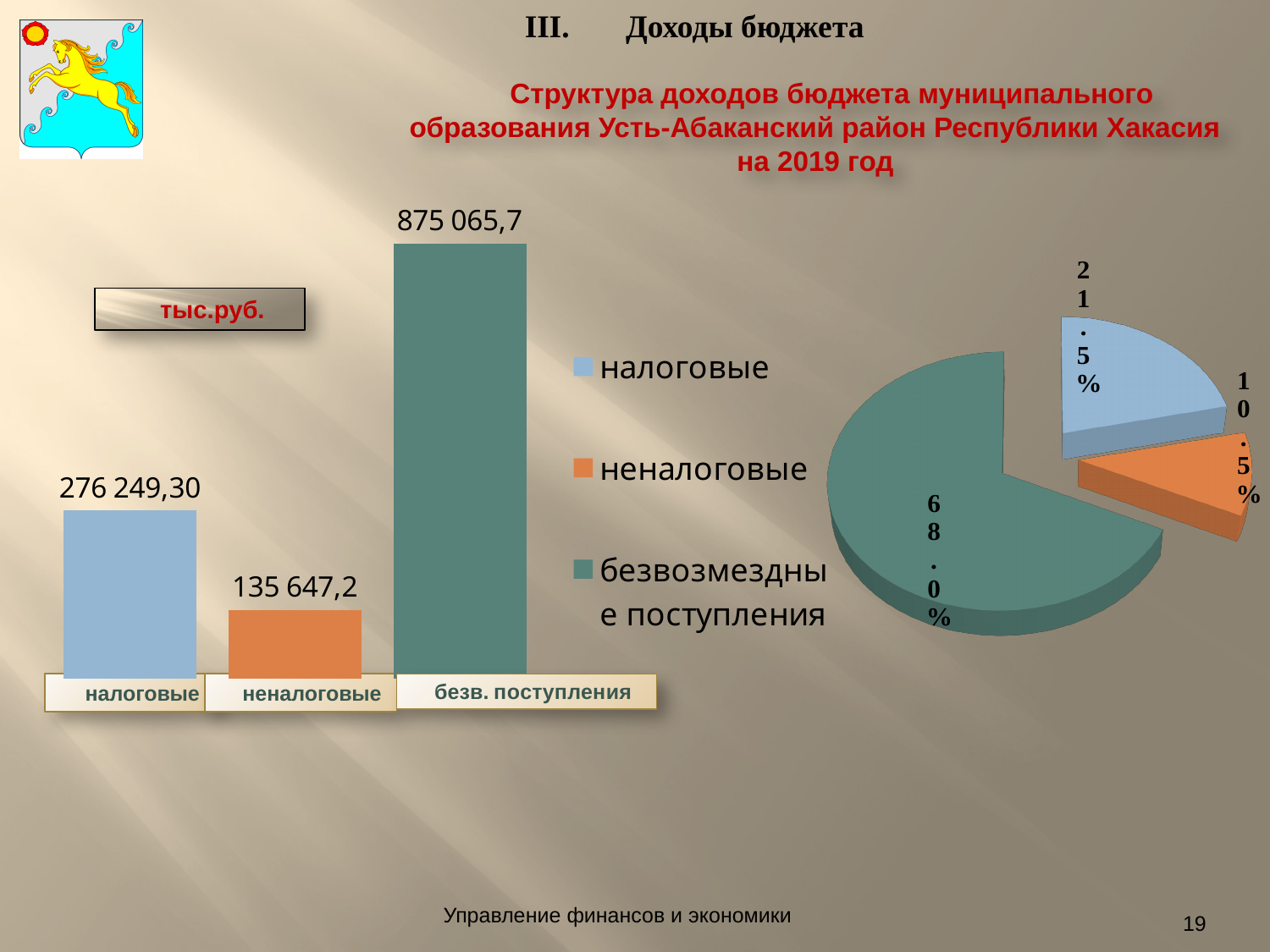
How many entries does the legend of the pie chart list? 3 What kind of chart is the chart on the left of the slide? bar chart On the bar chart on the left, which is larger: налоговые or неналоговые? налоговые On the bar chart on the left, how many categories are shown? 3 On the pie chart on the right, what share is shown for налоговые? 21.5% On the bar chart on the left, what is the value for неналоговые? 135 647,2 On the bar chart on the left, which category has the lowest value? неналоговые On the bar chart on the left, what is the value for безв. поступления? 875 065,7 On the bar chart on the left, which category has the highest value? безв. поступления What kind of chart is the chart on the right of the slide? pie chart On the pie chart on the right, what share is shown for безвозмездные поступления? 68.0% On the bar chart on the left, what is the value for налоговые? 276 249,30